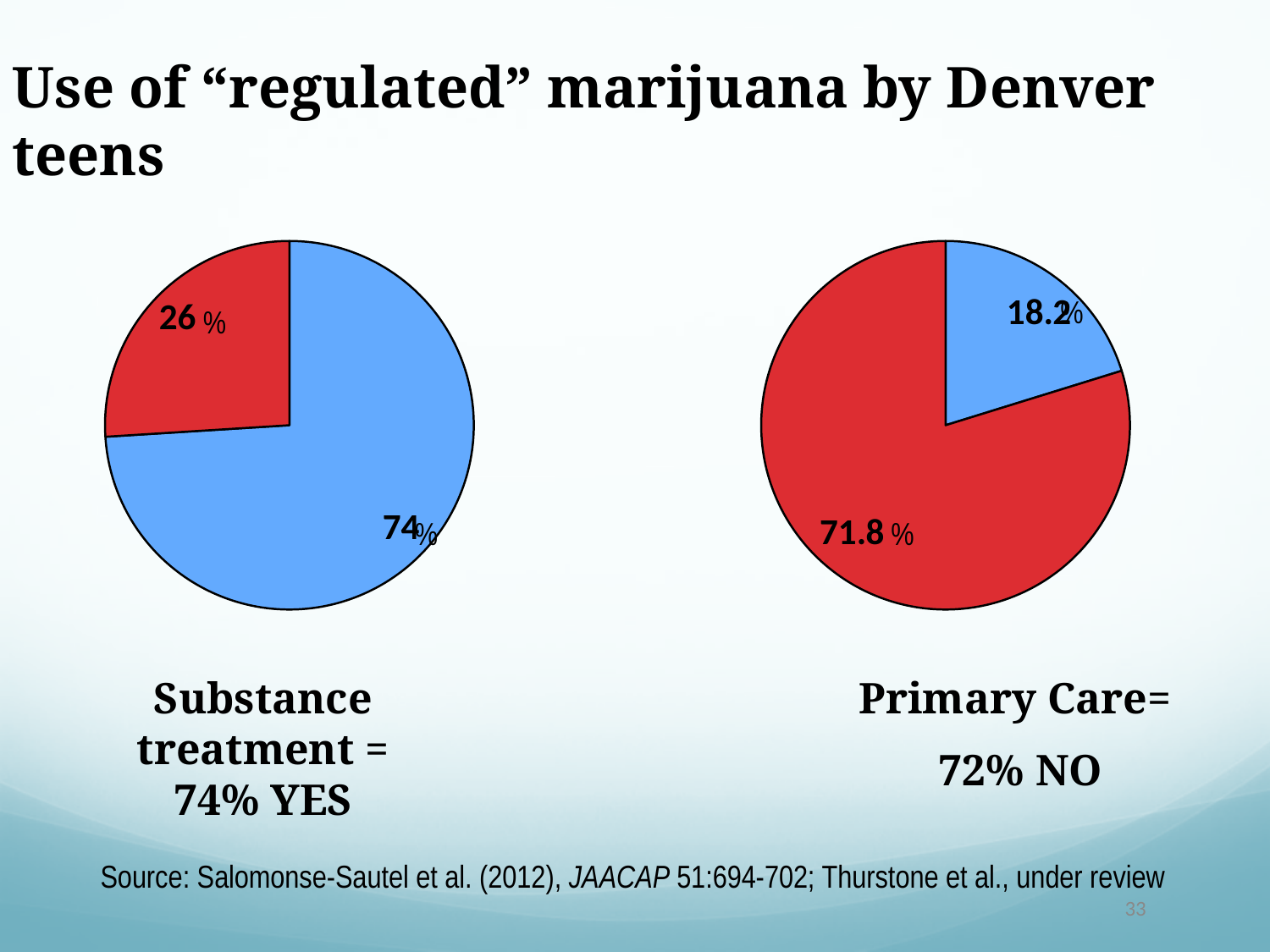
In the left pie chart (Substance treatment), what is the difference between the blue slice (74%) and the red slice (26%)? 48 percentage points In the right pie chart (Primary Care), which colour slice is the smallest? Blue Which is larger: the red slice of the left pie chart (Substance treatment) or the blue slice of the right pie chart (Primary Care)? The red slice of the left pie chart (26%) In the right pie chart (Primary Care), what is the difference between the red slice (71.8%) and the blue slice (18.2%)? 53.6 percentage points In the left pie chart (Substance treatment), what value is shown on the red slice? 26% In the right pie chart (Primary Care), what value is shown on the blue slice? 18.2% In the left pie chart (Substance treatment), how many slices are there? 2 What kind of chart is the chart on the left of the slide (Substance treatment)? Pie chart What is the title of the slide containing the two pie charts? Use of "regulated" marijuana by Denver teens In the left pie chart (Substance treatment), which colour slice is the largest? Blue In the right pie chart (Primary Care), what value is shown on the red slice? 71.8% In the left pie chart (Substance treatment), what value is shown on the blue slice? 74%